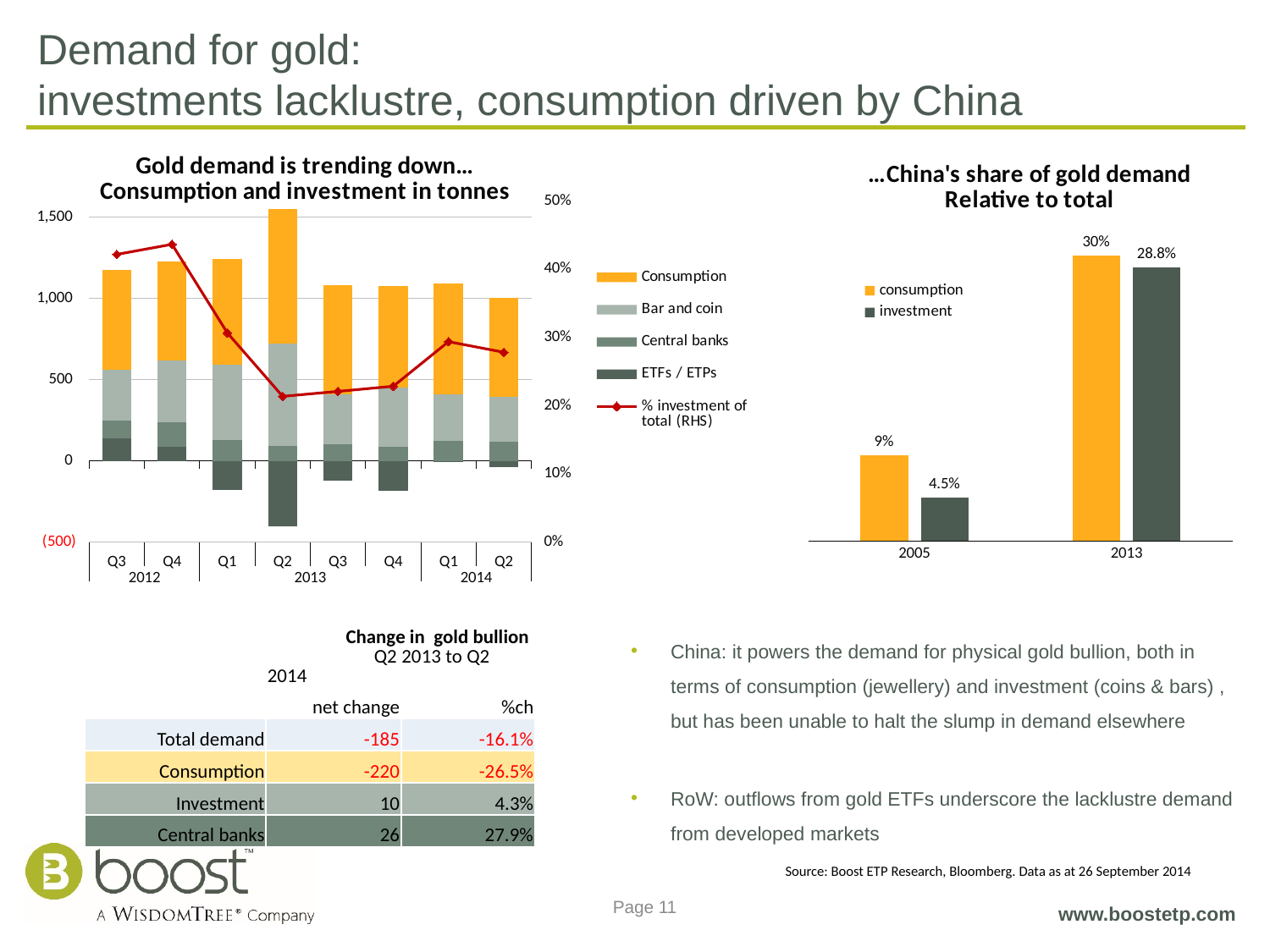
In the chart titled "Gold demand is trending down... Consumption and investment in tonnes", how many entries does the legend list? 5 In the chart titled "...China's share of gold demand Relative to total", what is the investment value for 2013? 28.8% In the chart titled "...China's share of gold demand Relative to total", how many series does the legend list? 2 In the chart titled "...China's share of gold demand Relative to total", which year has the highest consumption value? 2013 In the chart titled "Gold demand is trending down... Consumption and investment in tonnes", is the "% investment of total (RHS)" value for Q4 2012 greater or less than 40%? greater In the chart titled "...China's share of gold demand Relative to total", what is the difference between the consumption and investment values for 2005? 4.5% In the chart titled "...China's share of gold demand Relative to total", what is the consumption value for 2013? 30% In the chart titled "Gold demand is trending down... Consumption and investment in tonnes", which legend entry is plotted as a line rather than bars? % investment of total (RHS) In the chart titled "...China's share of gold demand Relative to total", which is larger in 2013, consumption or investment? consumption In the chart titled "...China's share of gold demand Relative to total", what kind of chart is it? bar chart In the chart titled "Gold demand is trending down... Consumption and investment in tonnes", how many quarters are shown on the x axis? 8 In the chart titled "...China's share of gold demand Relative to total", what is the investment value for 2005? 4.5%